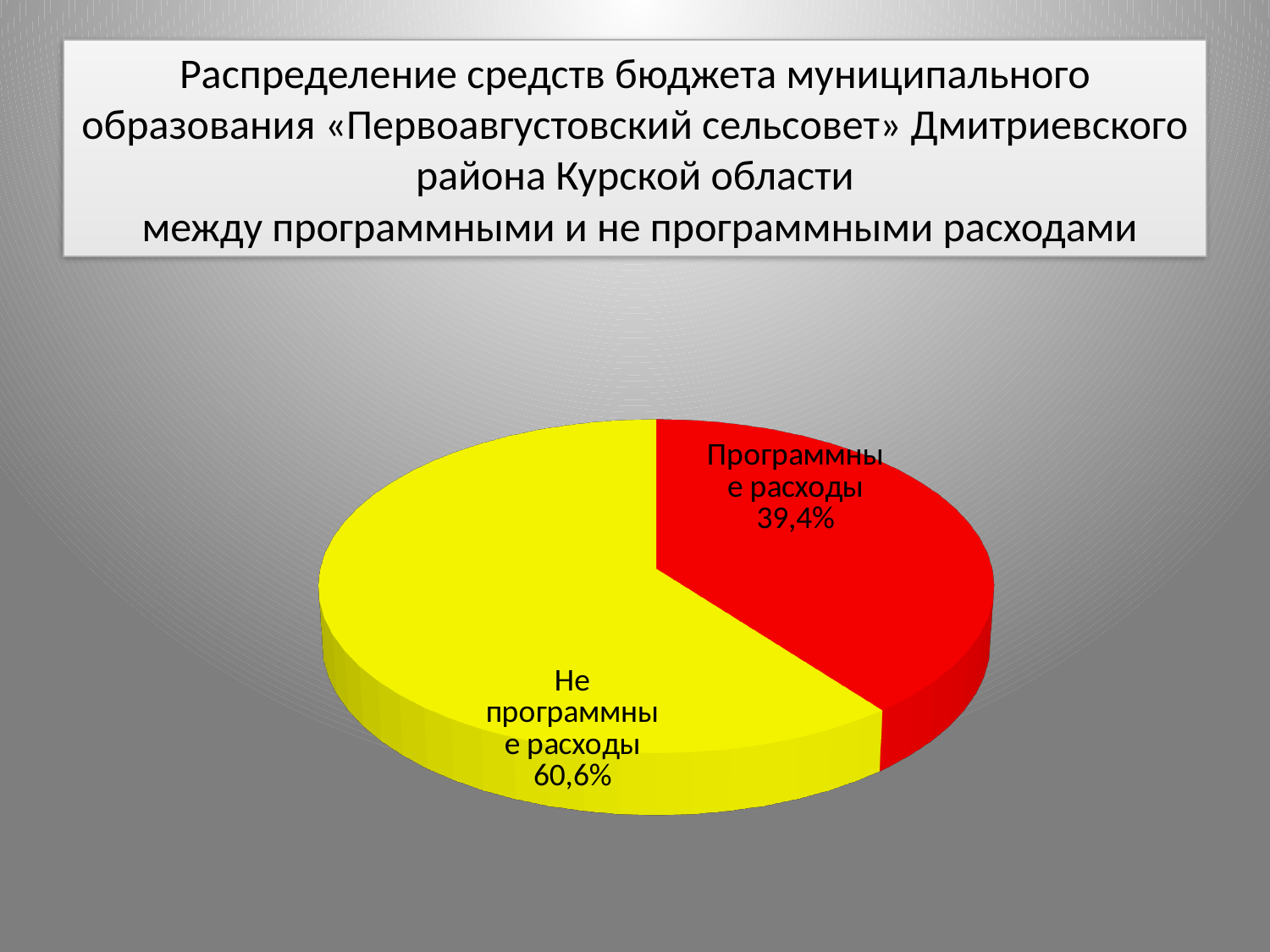
How many slices does the pie chart have? 2 What share of the pie is labelled "Программные расходы"? 39,4% What is the difference in percentage points between "Не программные расходы" and "Программные расходы"? 21,2 What colour is the slice for "Не программные расходы"? Yellow What colour is the slice for "Программные расходы"? Red Which slice of the pie is the largest? Не программные расходы Is the share for "Программные расходы" greater or less than 50%? less Which slice of the pie is the smallest? Программные расходы What share of the pie is labelled "Не программные расходы"? 60,6% What kind of chart is shown on the slide? Pie chart Which is larger: the share for "Программные расходы" or the share for "Не программные расходы"? Не программные расходы Is the share for "Не программные расходы" greater or less than 50%? greater